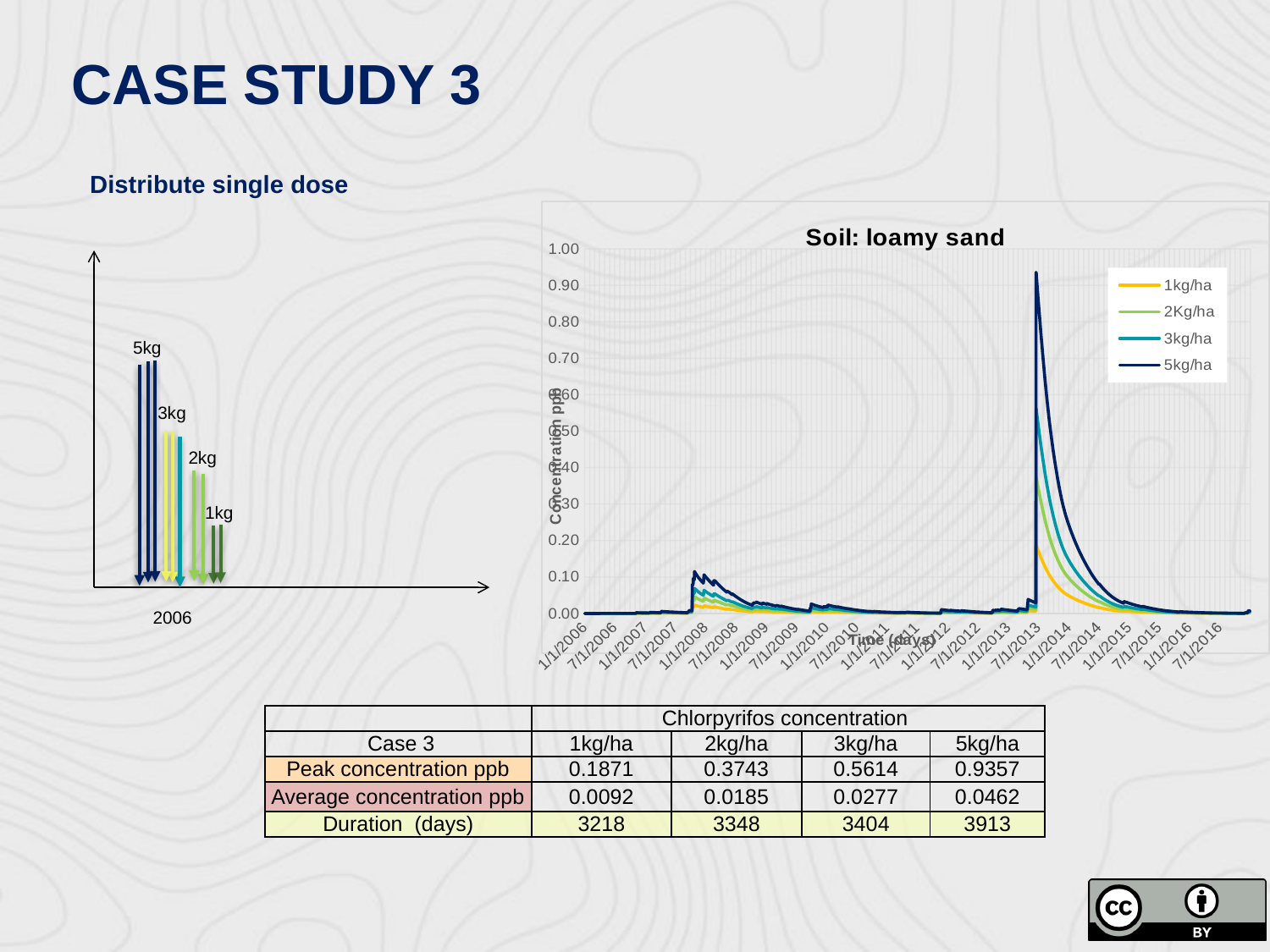
In the "Soil: loamy sand" chart, is the peak value of the 5kg/ha series greater or less than 0.80? greater In the "Soil: loamy sand" chart, is the peak value of the 2Kg/ha series greater or less than 0.30? greater In the "Soil: loamy sand" chart, which series peaks higher in 2013, 3kg/ha or 2Kg/ha? 3kg/ha How many series does the legend of the "Soil: loamy sand" chart list? 4 In the "Soil: loamy sand" chart, is the peak value of the 3kg/ha series greater or less than 0.50? greater What is the title of the chart on the right of the slide? Soil: loamy sand In the "Soil: loamy sand" chart, which series reaches the highest peak concentration? 5kg/ha In the "Soil: loamy sand" chart, which series has the lowest peak concentration? 1kg/ha What is the highest tick value shown on the y-axis of the "Soil: loamy sand" chart? 1.00 What is the y-axis title of the "Soil: loamy sand" chart? Concentration ppb What kind of chart is shown under the title "Soil: loamy sand"? line chart